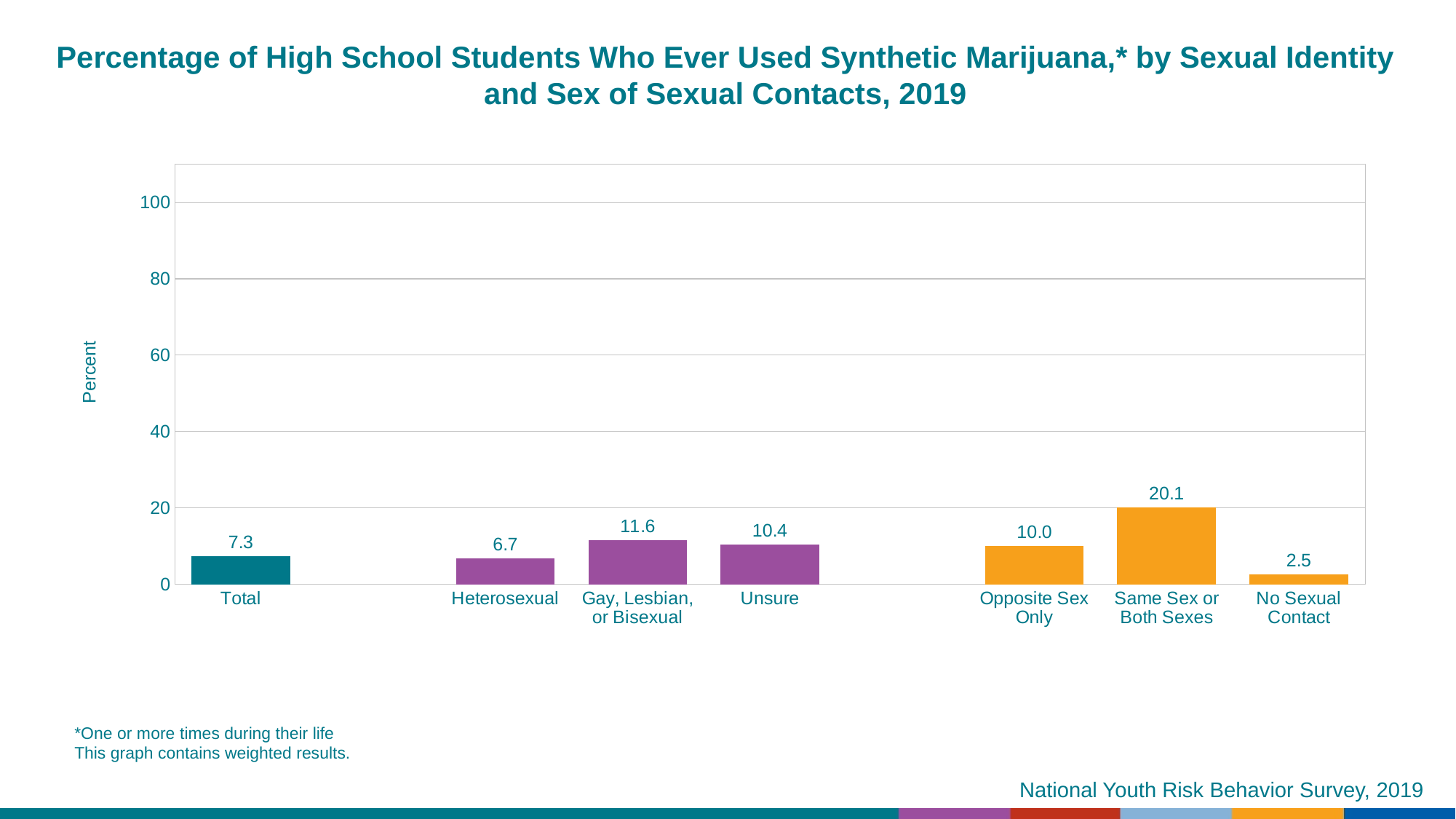
What is the value for Gay, Lesbian, or Bisexual? 11.6 Is the value for Same Sex or Both Sexes greater or less than 20? greater What is the value for Total? 7.3 What kind of chart is this? bar chart What is the difference between the values for Same Sex or Both Sexes and Opposite Sex Only? 10.1 Which category has the lowest value? No Sexual Contact How many categories are shown on the x axis? 7 Which is larger, the value for Heterosexual or the value for Unsure? Unsure What is the difference between the values for Gay, Lesbian, or Bisexual and Heterosexual? 4.9 What is the value for Same Sex or Both Sexes? 20.1 What is the label of the y axis? Percent Which category has the highest value? Same Sex or Both Sexes